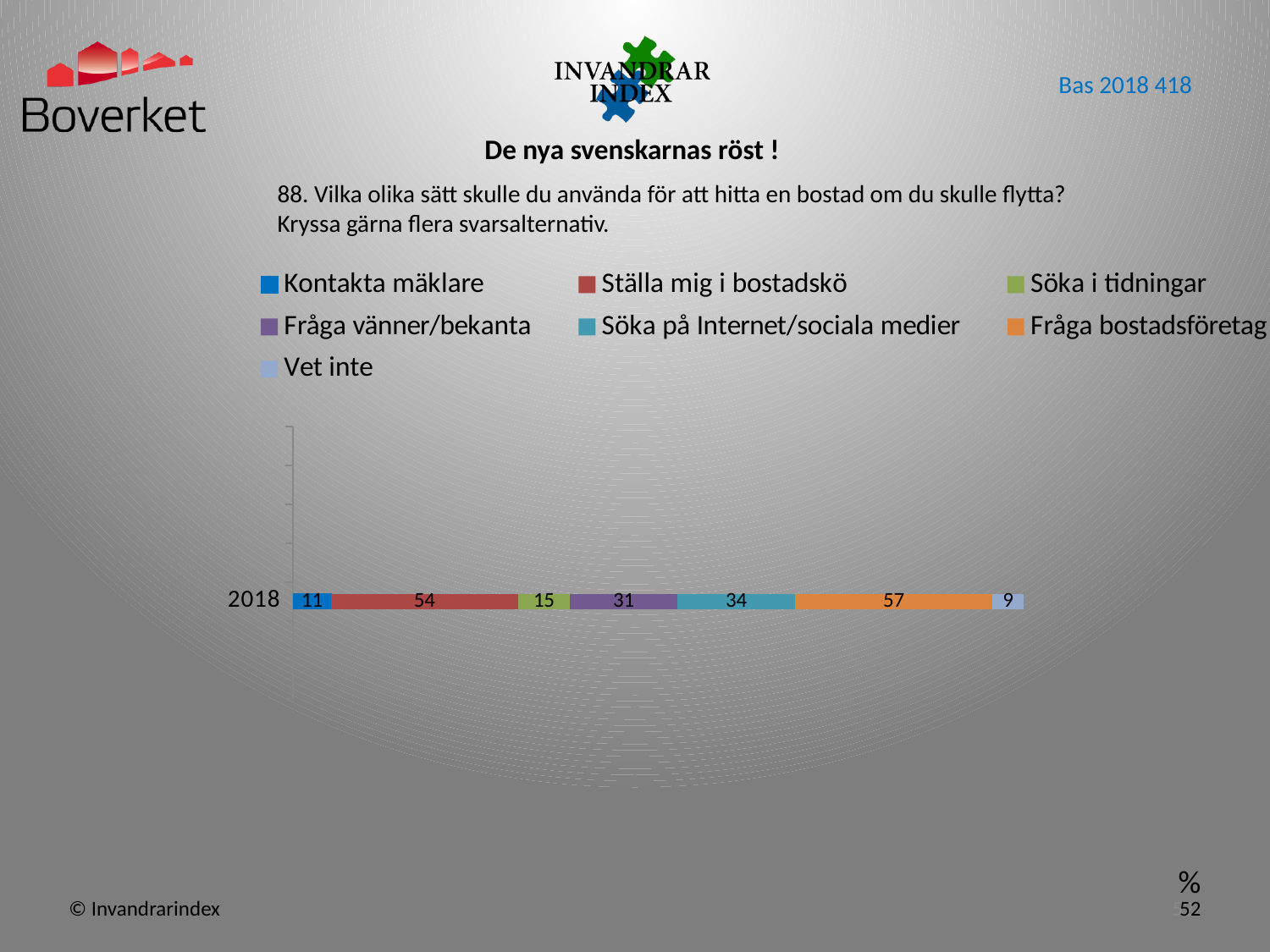
What kind of chart is shown on the slide? Stacked bar chart What is the value for Ställa mig i bostadskö in 2018? 54 What is the value for Söka på Internet/sociala medier in 2018? 34 What is the value for Vet inte in 2018? 9 What is the value for Kontakta mäklare in 2018? 11 Which series has the highest value in the 2018 bar? Fråga bostadsföretag How many series does the legend list? 7 What is the difference between Fråga bostadsföretag and Ställa mig i bostadskö in 2018? 3 Which is larger in 2018: Fråga vänner/bekanta or Söka i tidningar? Fråga vänner/bekanta How many categories are shown on the chart's axis? 1 Which series has the lowest value in the 2018 bar? Vet inte What is the total of the stacked bar for 2018? 211